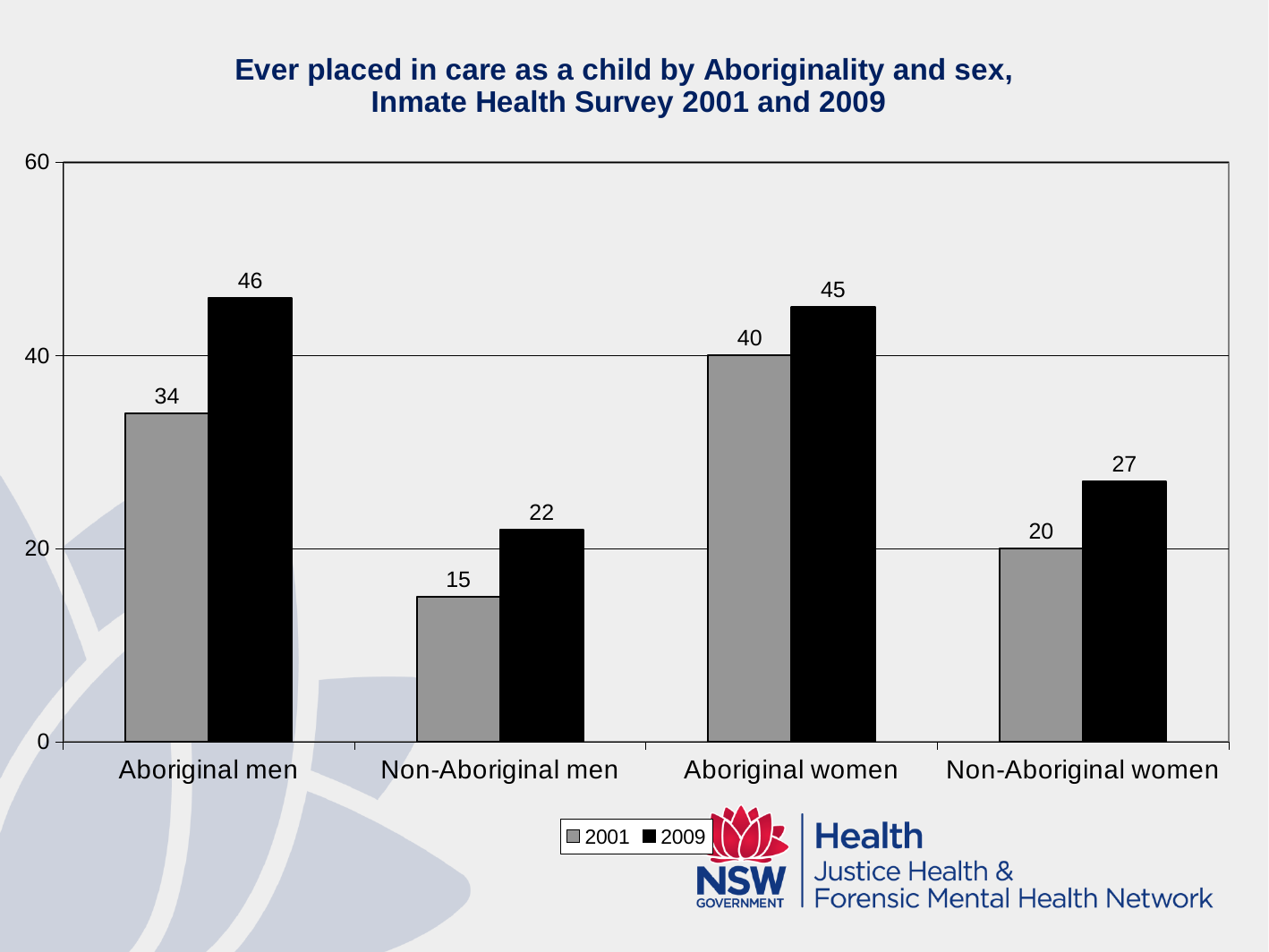
What is the 2001 value for Non-Aboriginal women? 20 How many series does the legend list? 2 What kind of chart is shown on the slide? Bar chart What is the 2009 value for Aboriginal men? 46 Which is larger: the 2001 value for Aboriginal men or the 2001 value for Aboriginal women? Aboriginal women What is the 2001 value for Aboriginal women? 40 How many categories are shown on the x axis? 4 Which category has the lowest 2001 value? Non-Aboriginal men What is the difference between the 2009 and 2001 values for Non-Aboriginal men? 7 Is the 2009 value for Non-Aboriginal women greater or less than 20? greater Which category has the highest 2009 value? Aboriginal men What is the difference between the 2009 values for Aboriginal women and Non-Aboriginal women? 18